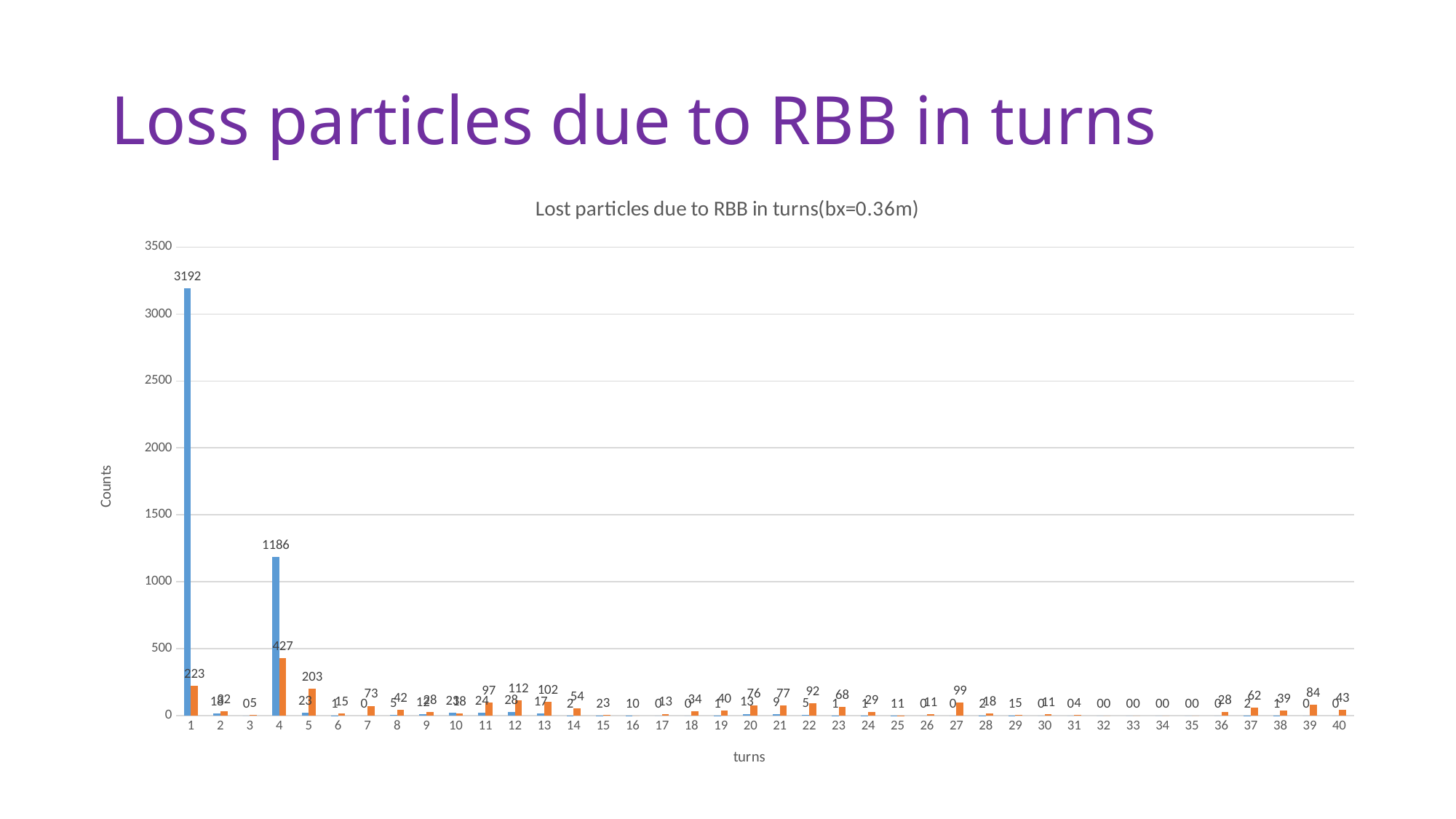
What is the difference between the blue bar at turn 1 and the blue bar at turn 4? 2006 How many turns are shown on the x axis? 40 What is the value of the orange bar at turn 5? 203 What type of chart is shown on the slide? bar chart What is the title of the chart? Lost particles due to RBB in turns(bx=0.36m) What is the value of the blue bar at turn 4? 1186 What is the value of the blue bar at turn 1? 3192 At which turn is the blue bar highest? 1 At which turn is the orange bar highest? 4 What is the value of the orange bar at turn 4? 427 What is the value of the orange bar at turn 1? 223 Which is larger at turn 4, the blue bar or the orange bar? blue bar